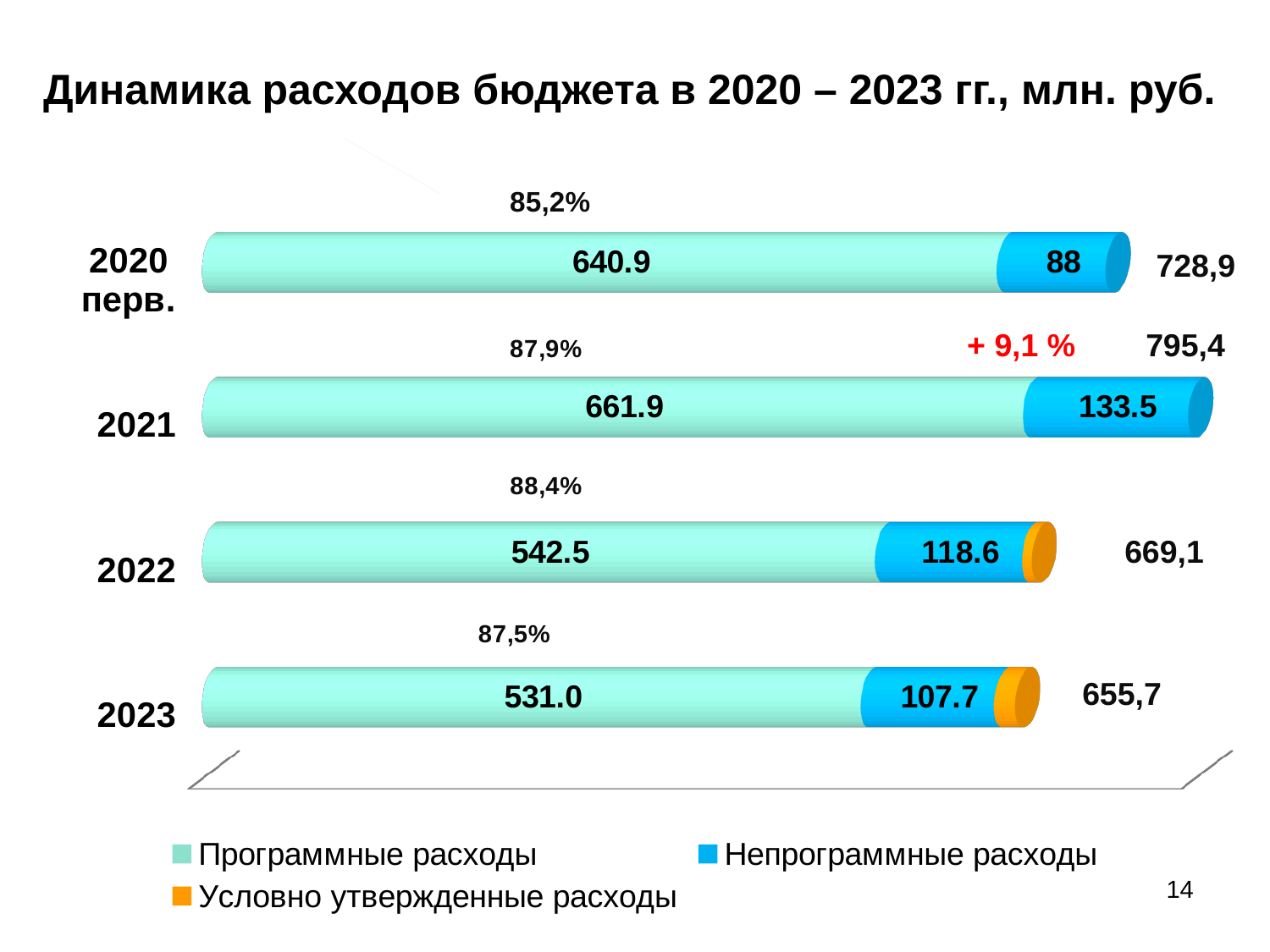
What is the total of the stacked bar for 2022? 669,1 What is the value of Программные расходы for 2021? 661.9 How many series does the legend list? 3 Which year has the highest value of Программные расходы? 2021 What is the value of Непрограммные расходы for 2023? 107.7 Which year has the lowest value of Непрограммные расходы? 2020 перв. What is the title of the chart? Динамика расходов бюджета в 2020 – 2023 гг., млн. руб. What is the difference between Программные расходы in 2021 and in 2022? 119.4 What is the value of Непрограммные расходы for 2020 перв.? 88 How many years (categories) are shown in the chart? 4 Which is larger: Непрограммные расходы in 2021 or in 2022? 2021 What kind of chart is shown on the slide? bar chart